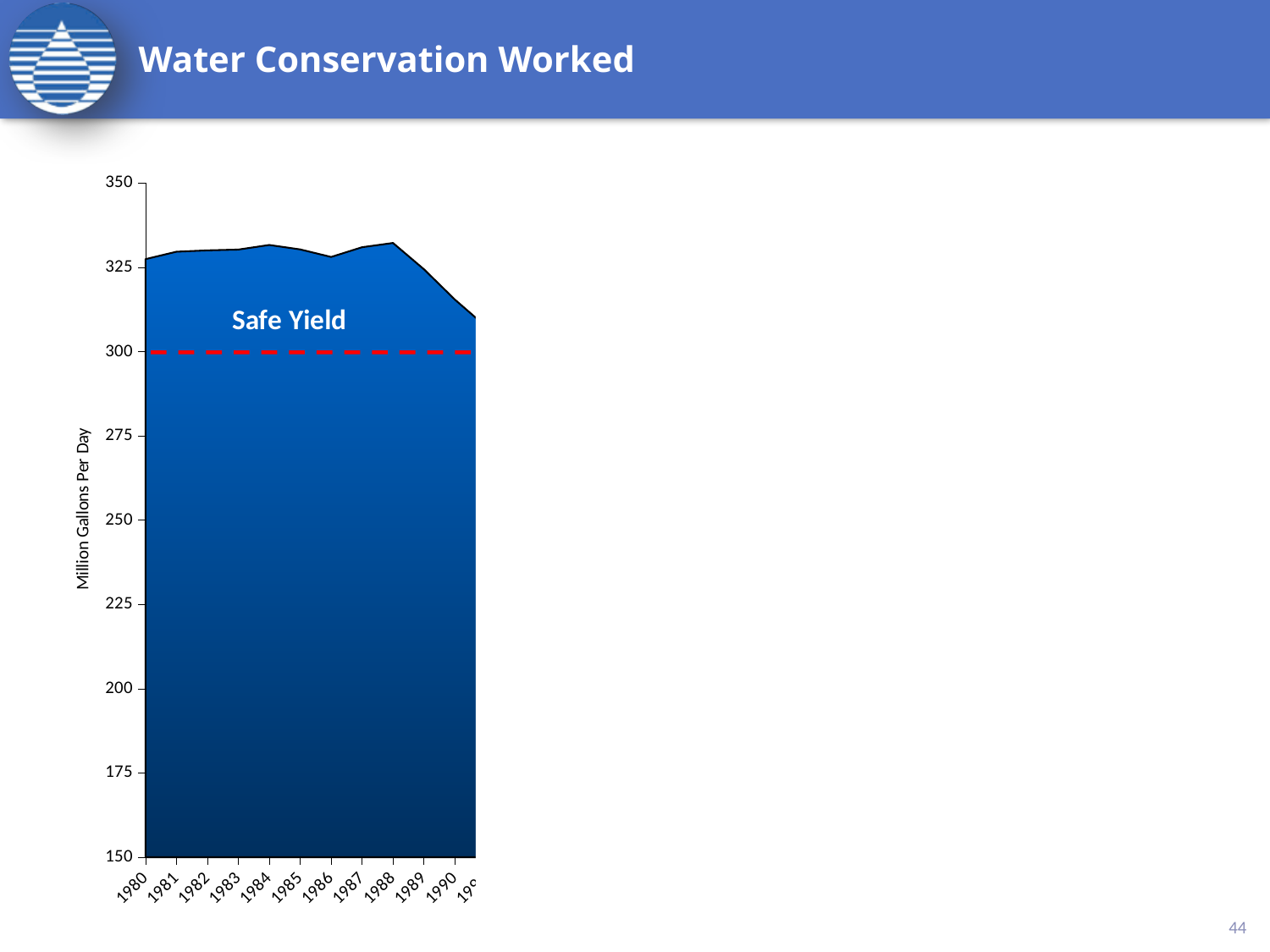
What kind of chart is shown on the slide? area chart Is the plotted value for 1990 above or below the Safe Yield line? above What colour is the dashed Safe Yield line? red What value does the Safe Yield dashed line sit at on the y axis? 300 What is the title of the y axis? Million Gallons Per Day Is the value for 1984 greater or less than 325? greater Is the value for 1988 greater or less than 325? greater Is the value for 1990 greater or less than 300? greater What is the lowest tick value shown on the y axis? 150 Which year has the larger value, 1988 or 1990? 1988 Do the values rise or fall from 1988 to 1990? fall